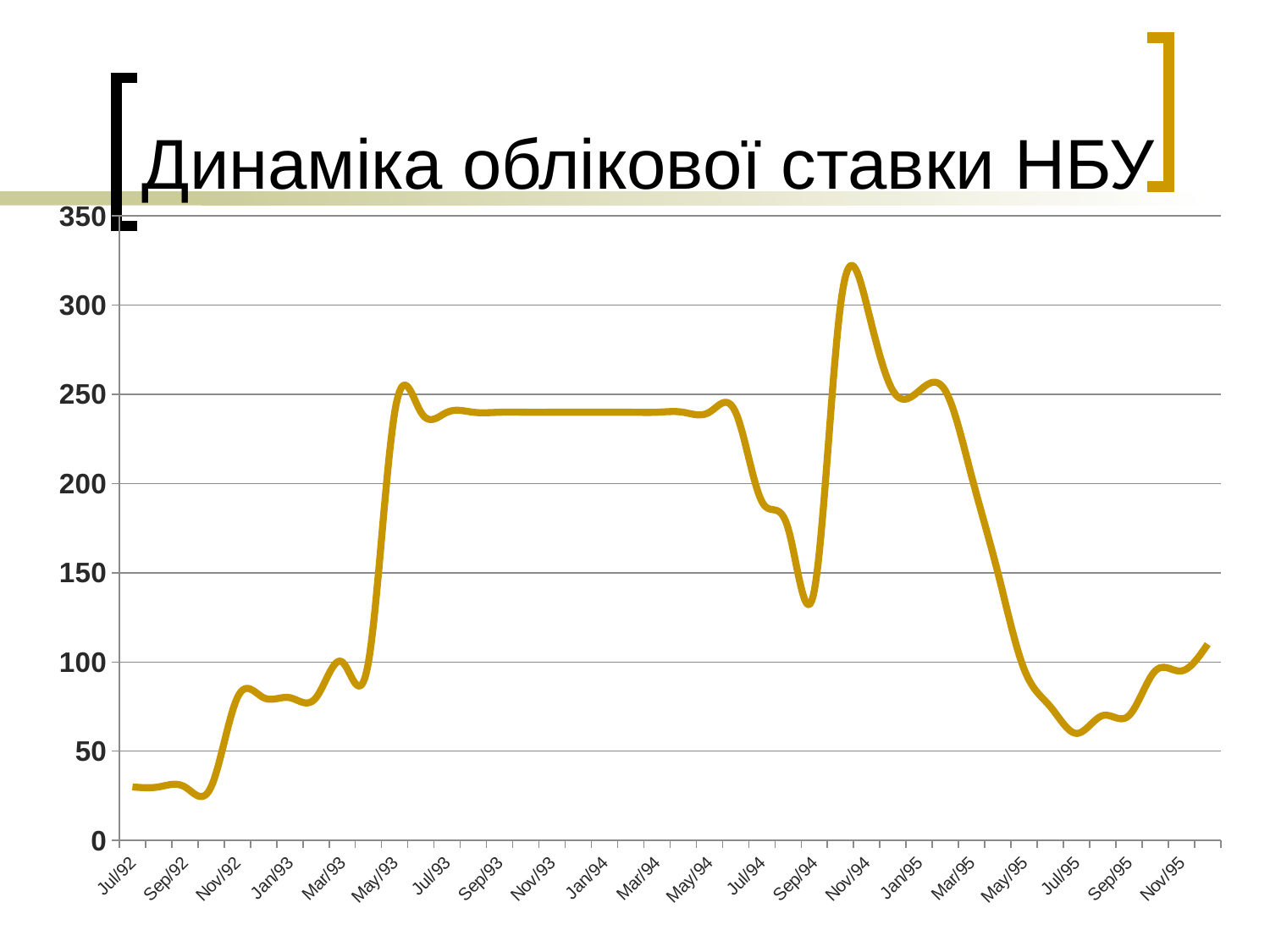
Is the value for Sep/93 greater or less than 200? greater Does the line rise or fall between Mar/95 and Jul/95? fall What kind of chart is shown on the slide? line chart Is the value for Sep/94 greater or less than 150? less How many month labels are shown on the x axis? 21 Which is larger, the value for Sep/93 or the value for Jul/95? Sep/93 What is the title of the chart? Динаміка облікової ставки НБУ Is the value for Jul/92 greater or less than 50? less Around which month does the line reach its highest value? Nov/94